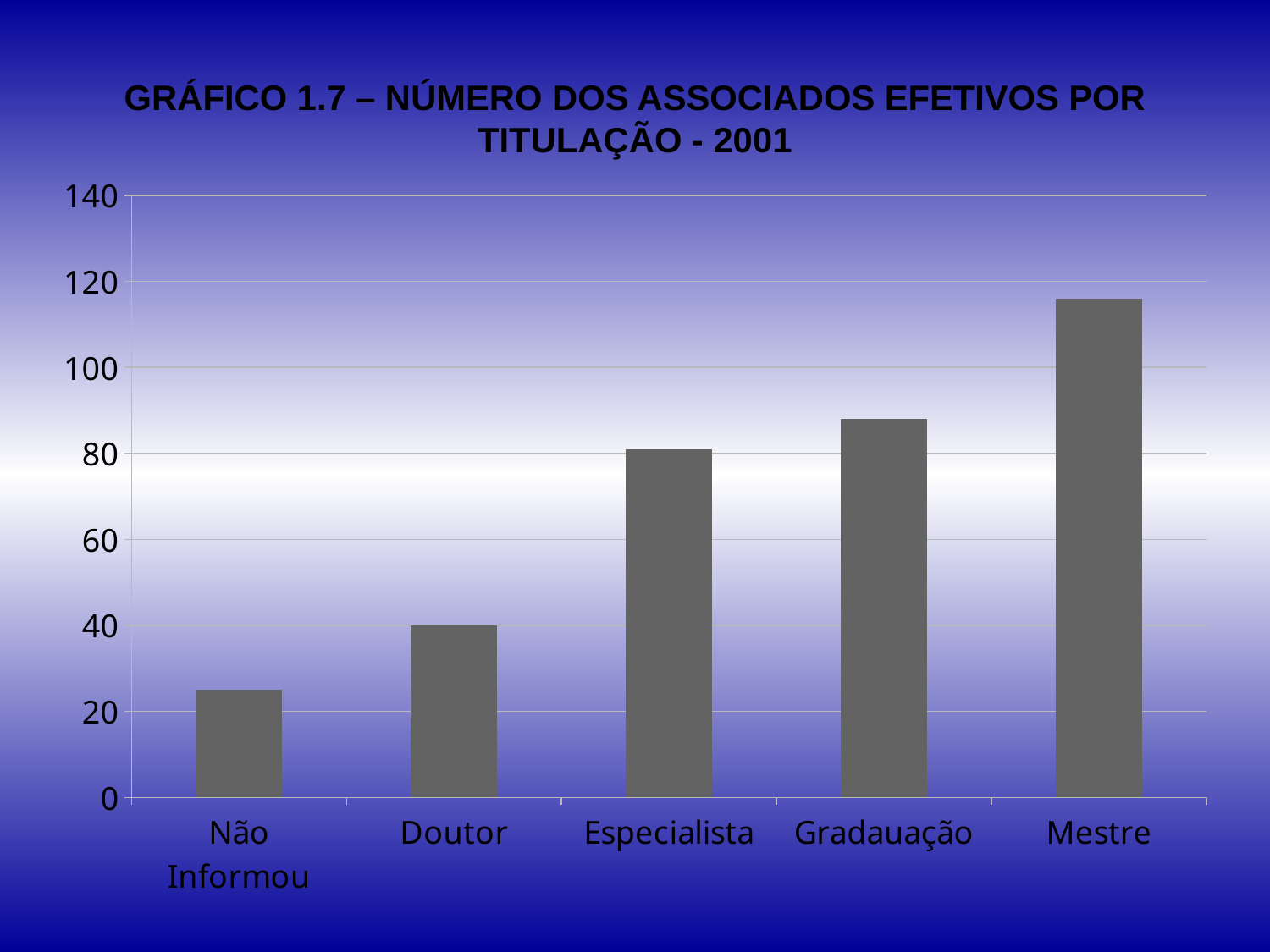
Which is larger, the value for Gradauação or the value for Especialista? Gradauação Do the values rise or fall from left to right along the x axis? rise Is the value for Não Informou greater or less than 20? greater What is the value for Doutor? 40 What kind of chart is shown on the slide? bar chart Which category has the lowest value in the chart? Não Informou Is the value for Mestre greater or less than 100? greater Is the value for Mestre greater or less than 120? less How many categories are shown on the x axis of the chart? 5 What year is referenced in the chart title? 2001 Which category has the highest value in the chart? Mestre